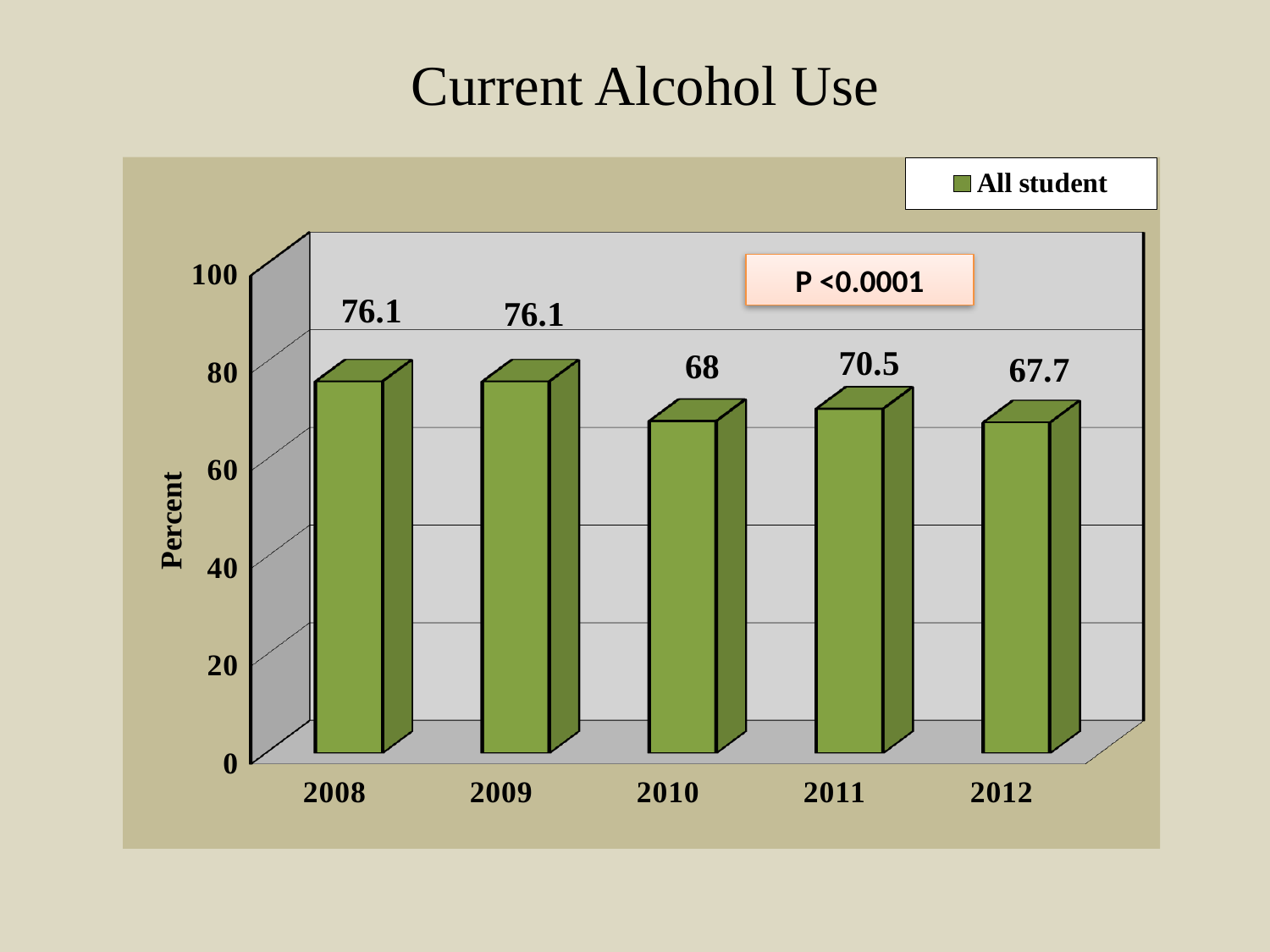
How many series does the legend list? 1 Which is larger, the value for 2010 or the value for 2011? 2011 What is the difference between the values for 2009 and 2010? 8.1 How many years are shown on the x axis? 5 Is the value for 2008 greater or less than 80? less What is the value for 2012? 67.7 What is the value for 2011? 70.5 What is the title of the chart? Current Alcohol Use What is the difference between the values for 2011 and 2012? 2.8 What kind of chart is shown? bar chart What is the value for 2010? 68 Which year has the lowest value? 2012